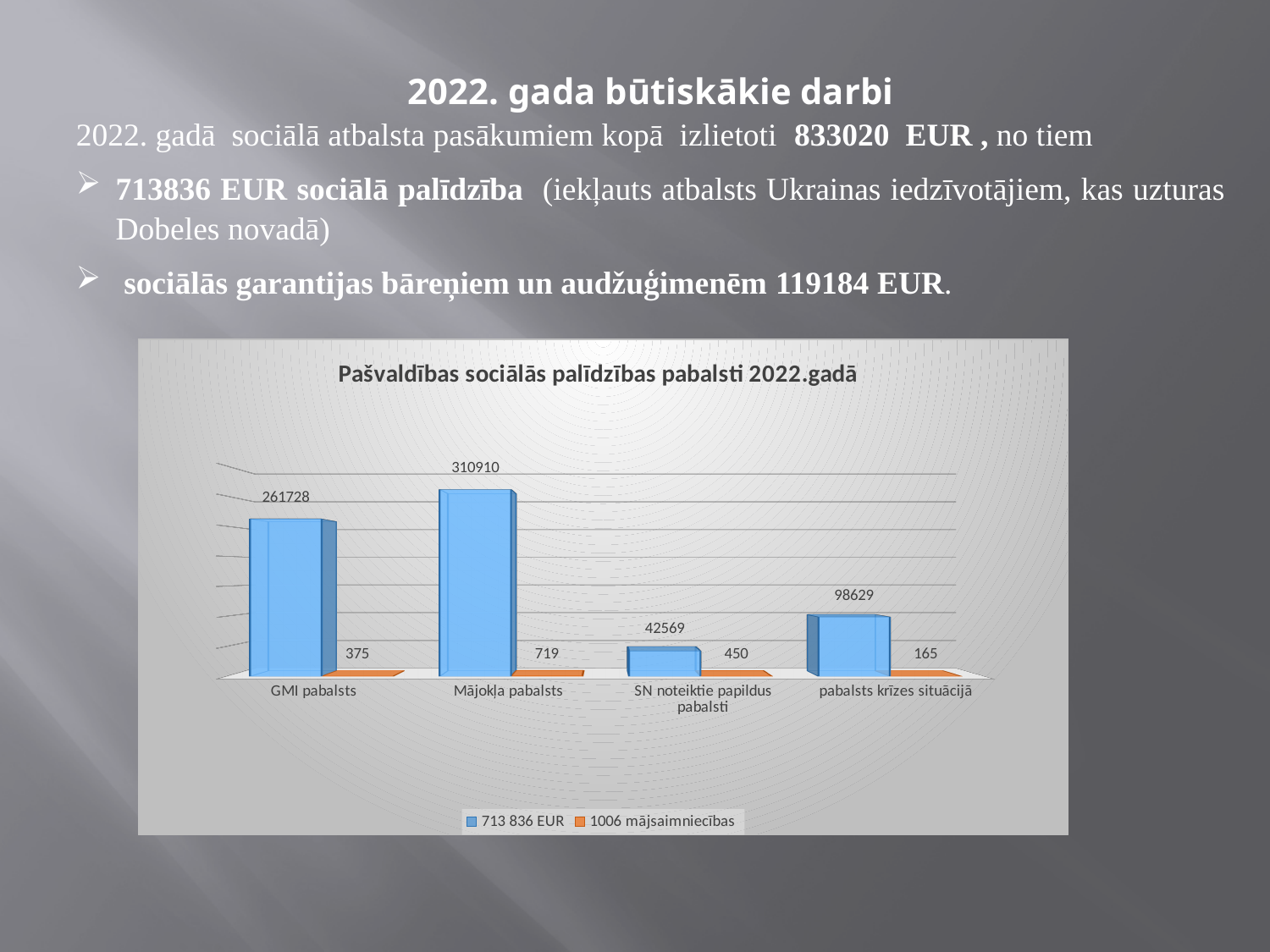
Which category has the highest value in the "713 836 EUR" series? Mājokļa pabalsts How many series does the chart legend list? 2 What is the value of the "713 836 EUR" series for SN noteiktie papildus pabalsti? 42569 What kind of chart is shown on the slide? Bar chart In the "1006 mājsaimniecības" series, which is larger: Mājokļa pabalsts or SN noteiktie papildus pabalsti? Mājokļa pabalsts What is the value of the "1006 mājsaimniecības" series for pabalsts krīzes situācijā? 165 What is the value of the "713 836 EUR" series for Mājokļa pabalsts? 310910 What is the value of the "1006 mājsaimniecības" series for GMI pabalsts? 375 What is the difference between the "713 836 EUR" values for Mājokļa pabalsts and GMI pabalsts? 49182 How many categories are shown on the x axis of the chart? 4 What is the title of the chart? Pašvaldības sociālās palīdzības pabalsti 2022.gadā Which category has the lowest value in the "1006 mājsaimniecības" series? pabalsts krīzes situācijā